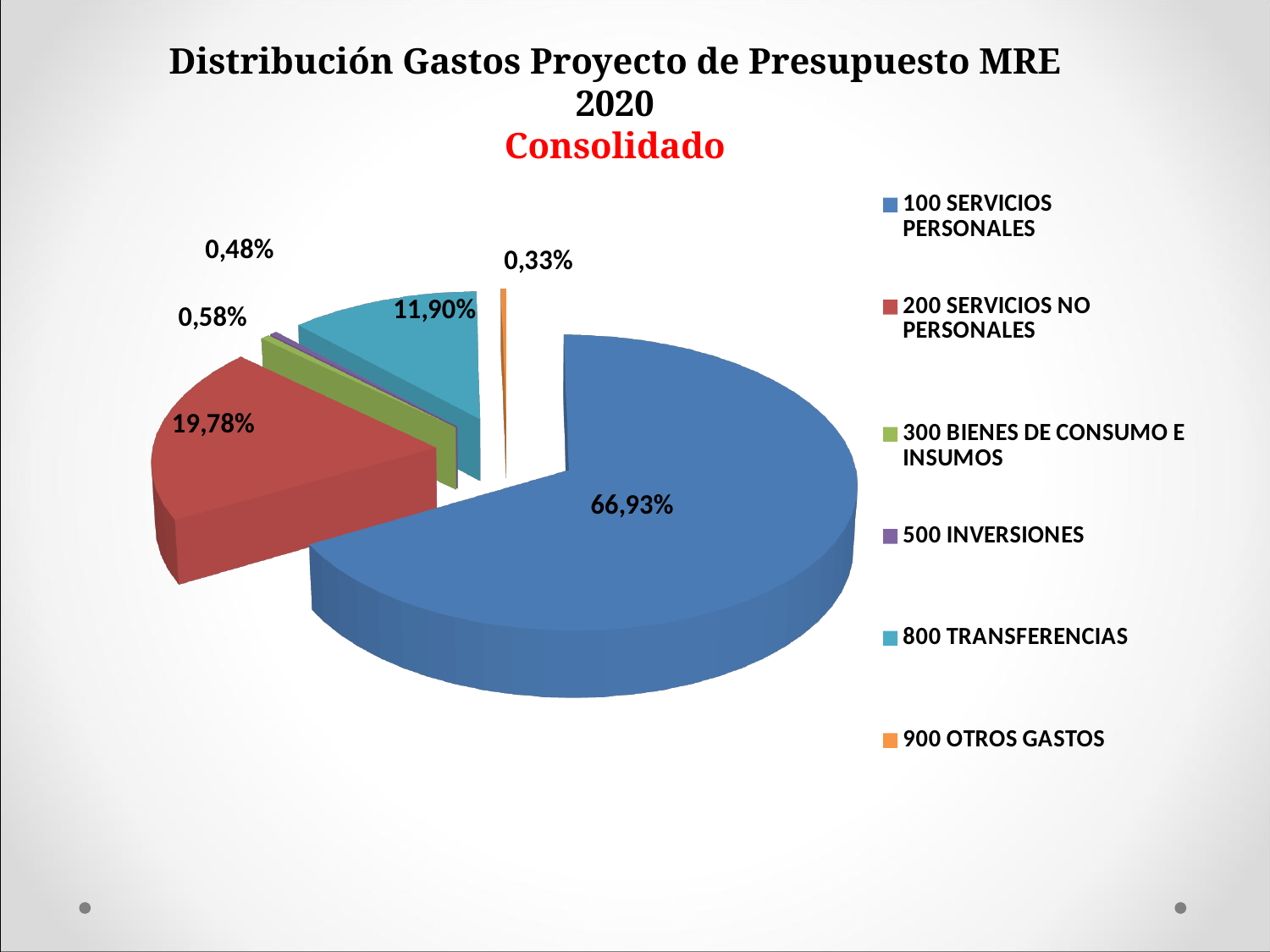
What is the value shown for 200 SERVICIOS NO PERSONALES? 19,78% What type of chart is shown on the slide? Pie chart What percentage is shown for 800 TRANSFERENCIAS? 11,90% What is the title of the chart? Distribución Gastos Proyecto de Presupuesto MRE 2020 Consolidado How many categories does the pie chart show? 6 What is the value for 900 OTROS GASTOS? 0,33% Which is larger, the slice for 200 SERVICIOS NO PERSONALES or the slice for 800 TRANSFERENCIAS? 200 SERVICIOS NO PERSONALES What colour is the slice for 800 TRANSFERENCIAS? Teal (light blue) Which category has the smallest slice of the pie? 900 OTROS GASTOS What is the difference in percentage points between 100 SERVICIOS PERSONALES and 200 SERVICIOS NO PERSONALES? 47,15 What share of the pie does 100 SERVICIOS PERSONALES represent? 66,93% Which category has the largest slice of the pie? 100 SERVICIOS PERSONALES